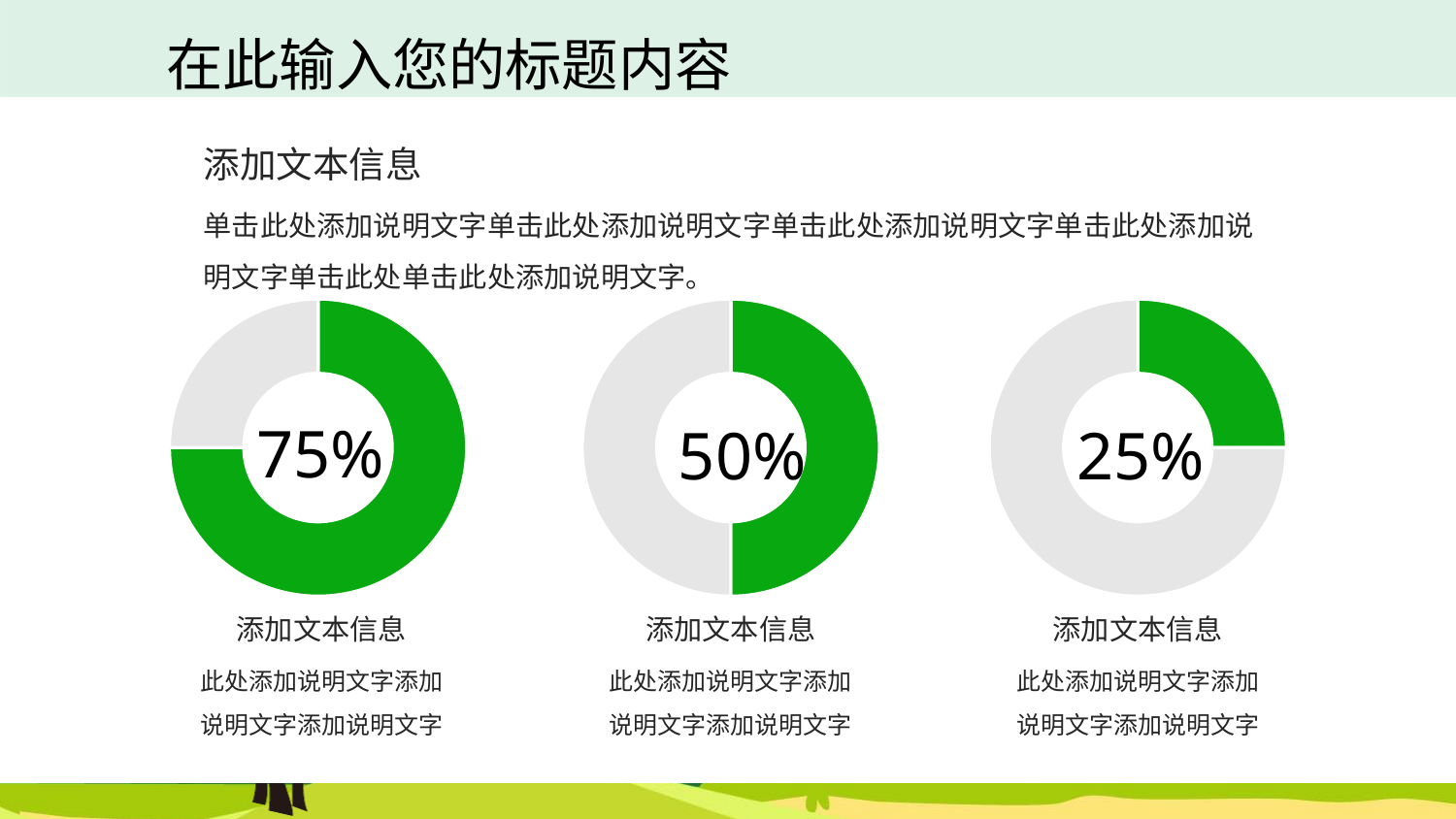
What percentage is shown in the centre of the middle donut chart? 50% Which of the three donut charts shows the highest percentage? The left chart (75%) What is the difference between the percentage in the left donut chart and the percentage in the right donut chart? 50% What percentage is shown in the centre of the left donut chart? 75% Which of the three donut charts shows the lowest percentage? The right chart (25%) What is the difference between the percentage in the left donut chart and the percentage in the middle donut chart? 25% What percentage is shown in the centre of the right donut chart? 25% Which is larger, the percentage in the middle donut chart or the percentage in the right donut chart? The middle chart (50%) What kind of chart is used for the three percentages on the slide? Donut chart How many donut charts are on the slide? 3 What colour is the filled portion of each donut chart? Green Do the percentages rise or fall going from the left chart to the right chart? Fall